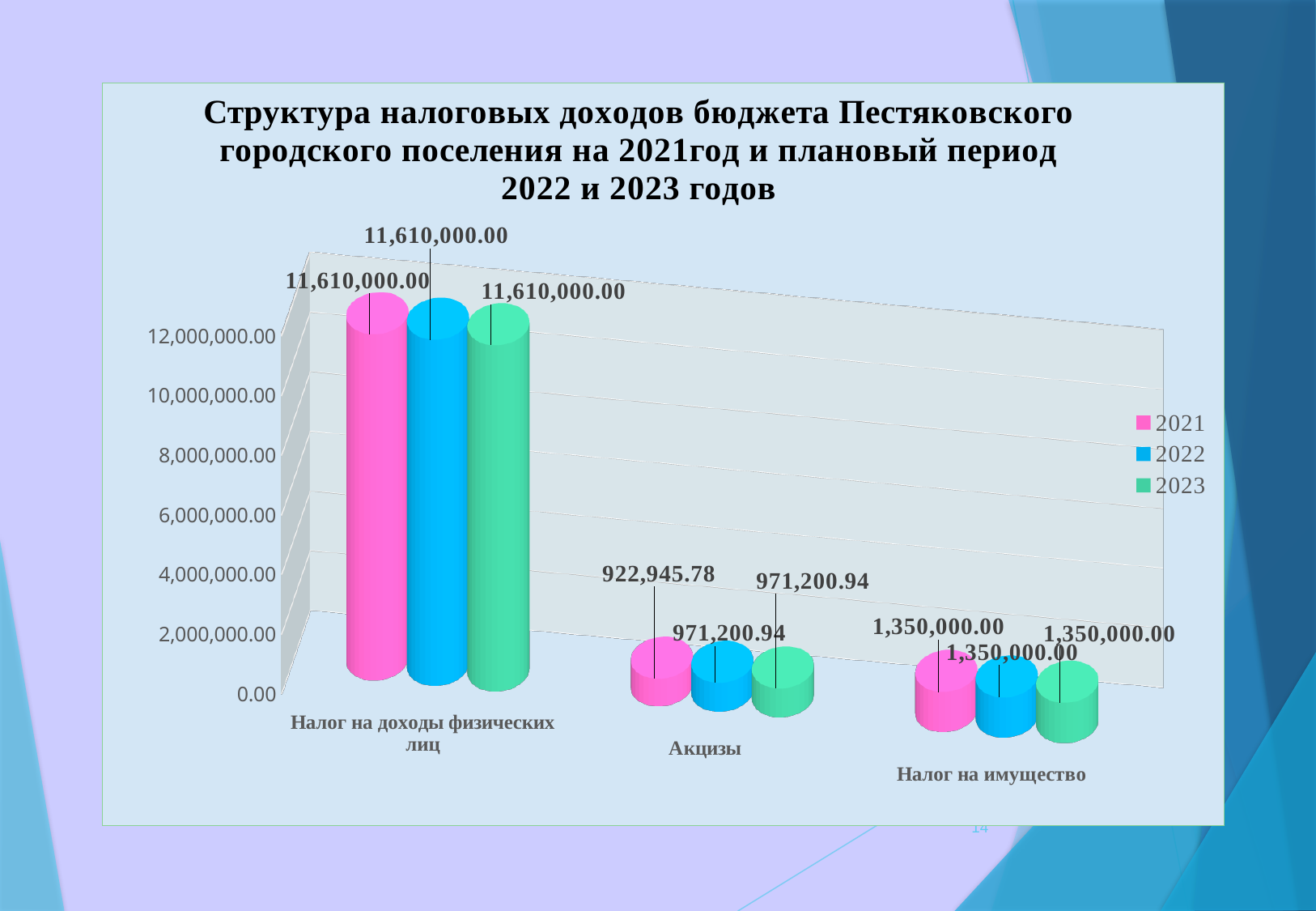
Which category has the highest value in 2022? Налог на доходы физических лиц How many categories are shown on the x axis? 3 What is the value for Налог на доходы физических лиц in 2021? 11,610,000.00 What is the value for Акцизы in 2021? 922,945.78 What kind of chart is shown on the slide? bar chart How many series does the legend list? 3 Is the value for Налог на доходы физических лиц in 2023 greater or less than 10,000,000.00? greater Which is larger in 2023: Акцизы or Налог на имущество? Налог на имущество What is the value for Акцизы in 2022? 971,200.94 What is the difference between the 2022 and 2021 values for Акцизы? 48,255.16 Which category has the lowest value in 2021? Акцизы What is the value for Налог на имущество in 2023? 1,350,000.00